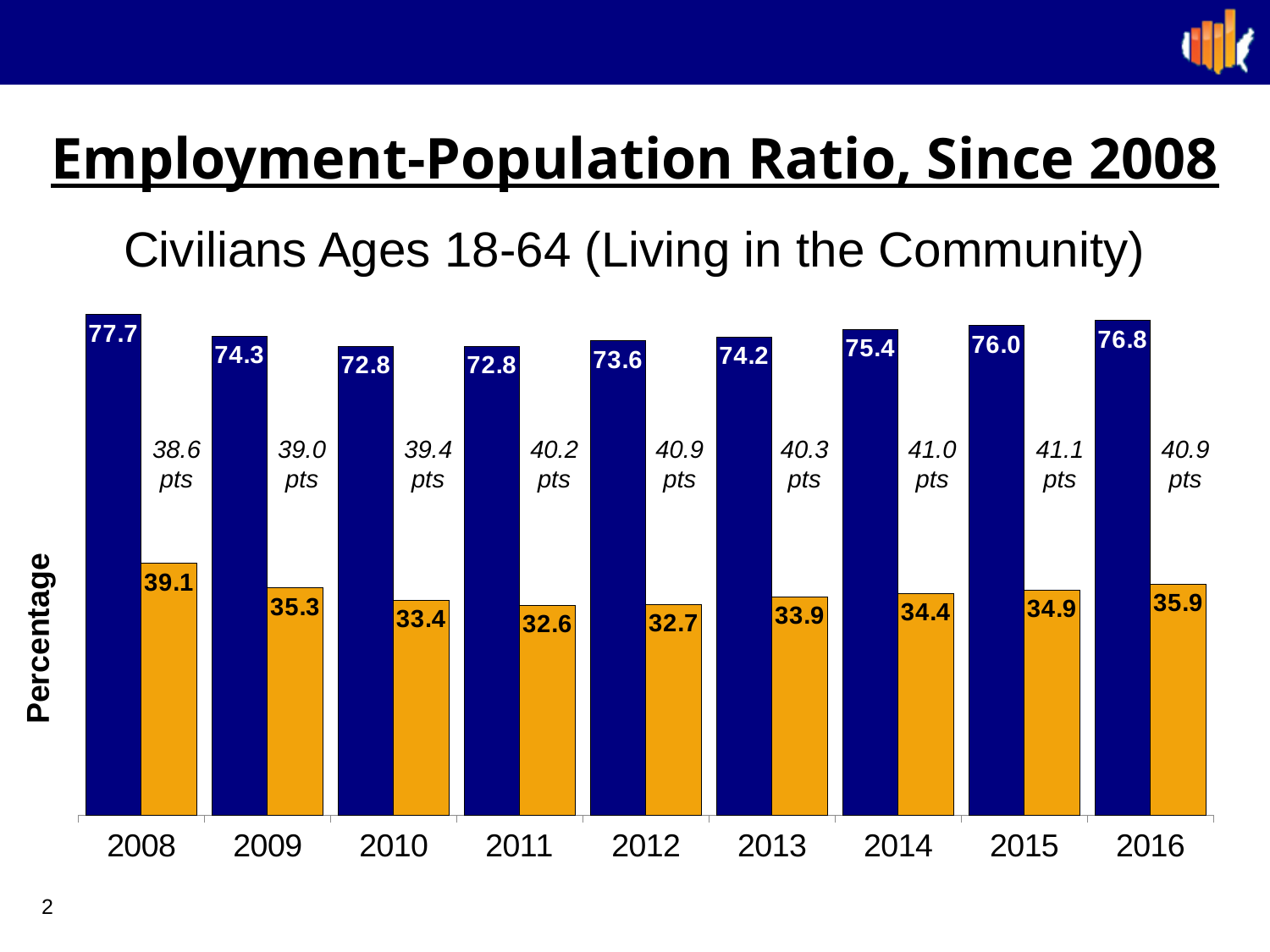
What is the label on the y axis? Percentage What is the value of the orange bar for 2016? 35.9 In which year is the dark blue bar the highest? 2008 Which is larger, the orange bar for 2009 or the orange bar for 2015? 2009 In which year is the orange bar the lowest? 2011 What is the value of the dark blue bar for 2008? 77.7 What kind of chart is shown on the slide? bar chart What is the value of the orange bar for 2011? 32.6 What is the difference between the dark blue bar values for 2008 and 2016? 0.9 How many years are shown on the x axis? 9 What is the gap in points shown between the two bars for 2015? 41.1 pts Do the dark blue bar values rise or fall from 2011 to 2016? rise